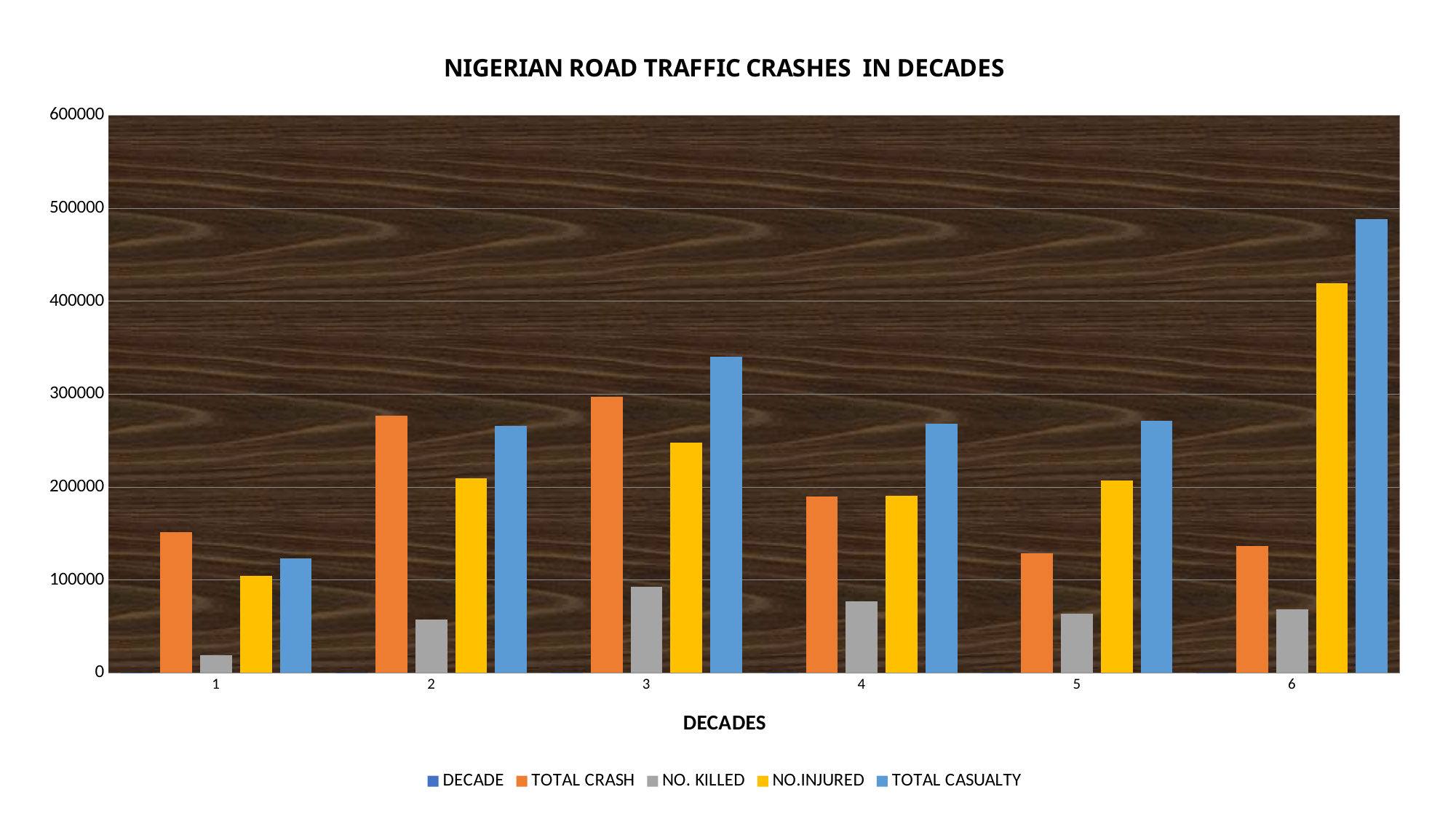
How many series does the legend list? 5 What is the title of the chart? NIGERIAN ROAD TRAFFIC CRASHES IN DECADES Which decade has the highest TOTAL CASUALTY value? 6 Is the NO.INJURED value for decade 3 greater or less than 200000? greater Is the TOTAL CRASH value for decade 1 greater or less than 200000? less How many decades are shown on the x axis? 6 Which decade has the highest TOTAL CRASH value? 3 Which decade has the highest NO.INJURED value? 6 Is the TOTAL CASUALTY value for decade 6 greater or less than 400000? greater Which is larger: the TOTAL CRASH value for decade 2 or for decade 4? decade 2 What kind of chart is shown on the slide? bar chart Which decade has the lowest NO. KILLED value? 1